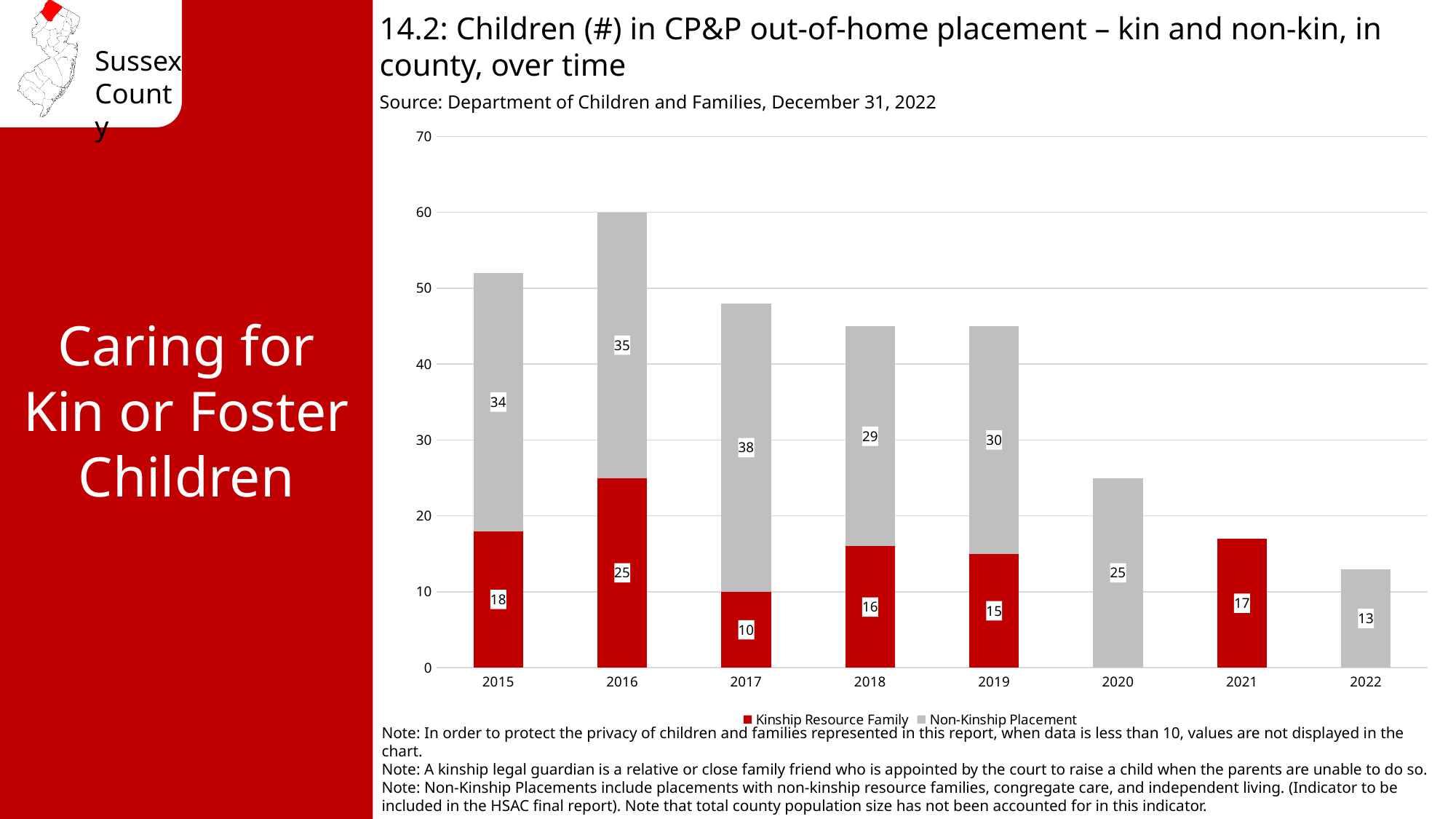
How many series does the legend list? 2 How many years are shown on the x axis? 8 In which year is the Non-Kinship Placement value highest? 2017 What is the value for Non-Kinship Placement in 2017? 38 What is the difference between Non-Kinship Placement and Kinship Resource Family in 2016? 10 What is the value for Non-Kinship Placement in 2022? 13 Among the years with a Kinship Resource Family label shown, which year has the lowest value? 2017 Which is larger: Non-Kinship Placement in 2018 or in 2019? 2019 What is the value for Kinship Resource Family in 2016? 25 What is the total of the stacked bar for 2015? 52 What is the total of the stacked bar for 2016? 60 What kind of chart is shown? Stacked bar chart